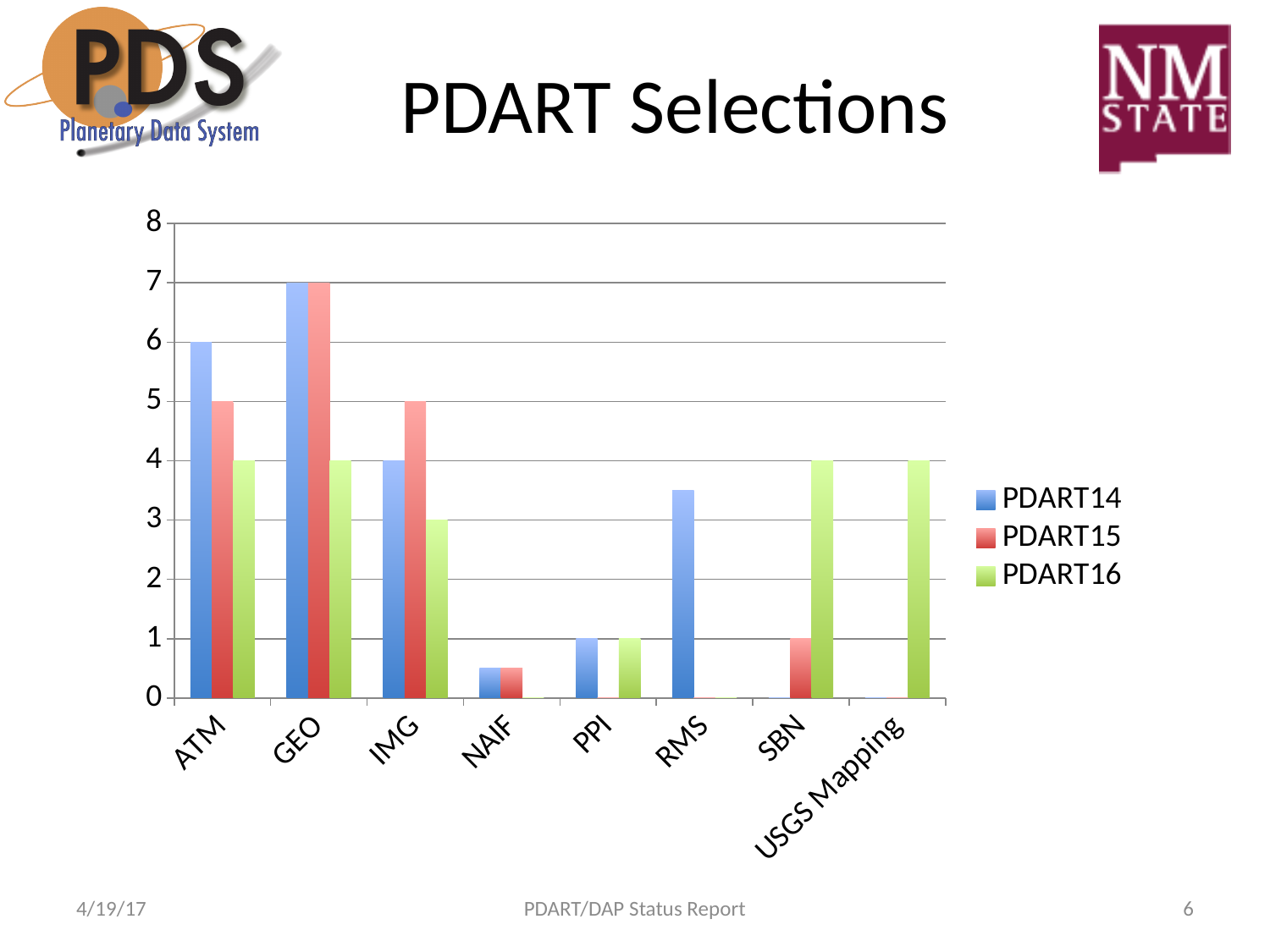
How many categories are shown along the x axis? 8 Is the PDART14 value for RMS greater or less than 3? greater Is the PDART14 value for NAIF greater or less than 1? less What is the title of the slide containing the chart? PDART Selections For ATM, which is larger: the PDART14 value or the PDART16 value? PDART14 What is the difference between the PDART14 and PDART15 values for ATM? 1 How many series does the legend list? 3 Which category has the highest PDART14 value? GEO What is the PDART14 value for ATM? 6 What kind of chart is shown on the slide? bar chart What is the PDART14 value for GEO? 7 What is the PDART16 value for SBN? 4